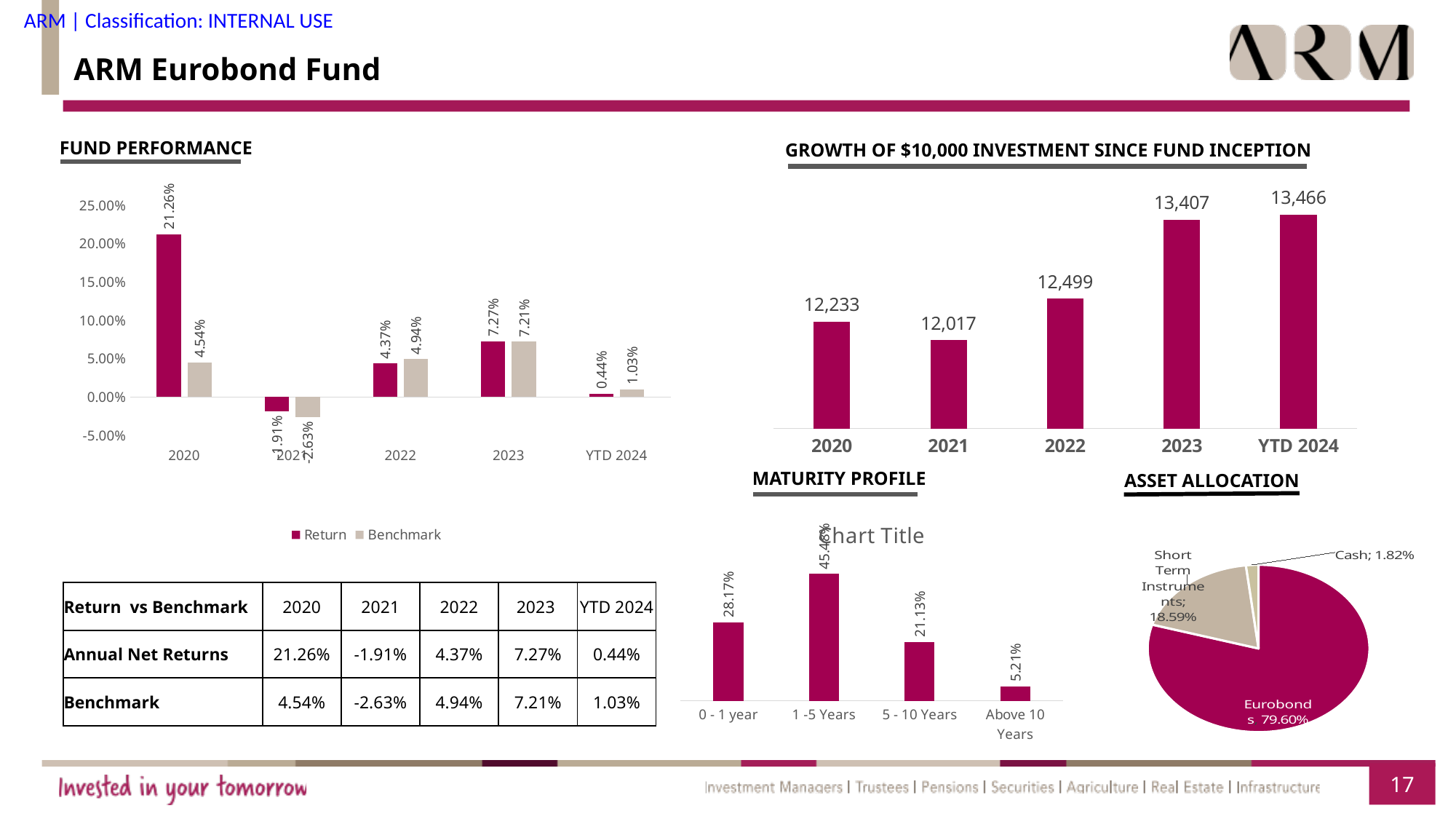
In the Growth of $10,000 Investment Since Fund Inception chart, what is the difference between the 2023 and 2022 values? 908 In the Growth of $10,000 Investment Since Fund Inception chart, what is the value for 2020? 12,233 In the Maturity Profile chart, which category has the highest value? 1 -5 Years How many series does the legend of the Fund Performance chart list? 2 In the Fund Performance chart, what is the Return value for 2020? 21.26% In the Fund Performance chart, which is larger for 2022, the Return or the Benchmark? Benchmark In the Growth of $10,000 Investment Since Fund Inception chart, which year has the lowest value? 2021 How many categories are shown in the Growth of $10,000 Investment Since Fund Inception chart? 5 In the Fund Performance chart, what is the difference between the Return and the Benchmark for 2020? 16.72% In the Fund Performance chart, what is the Benchmark value for 2021? -2.63% In the Maturity Profile chart, what is the value for Above 10 Years? 5.21% What kind of chart is the Asset Allocation chart? Pie chart